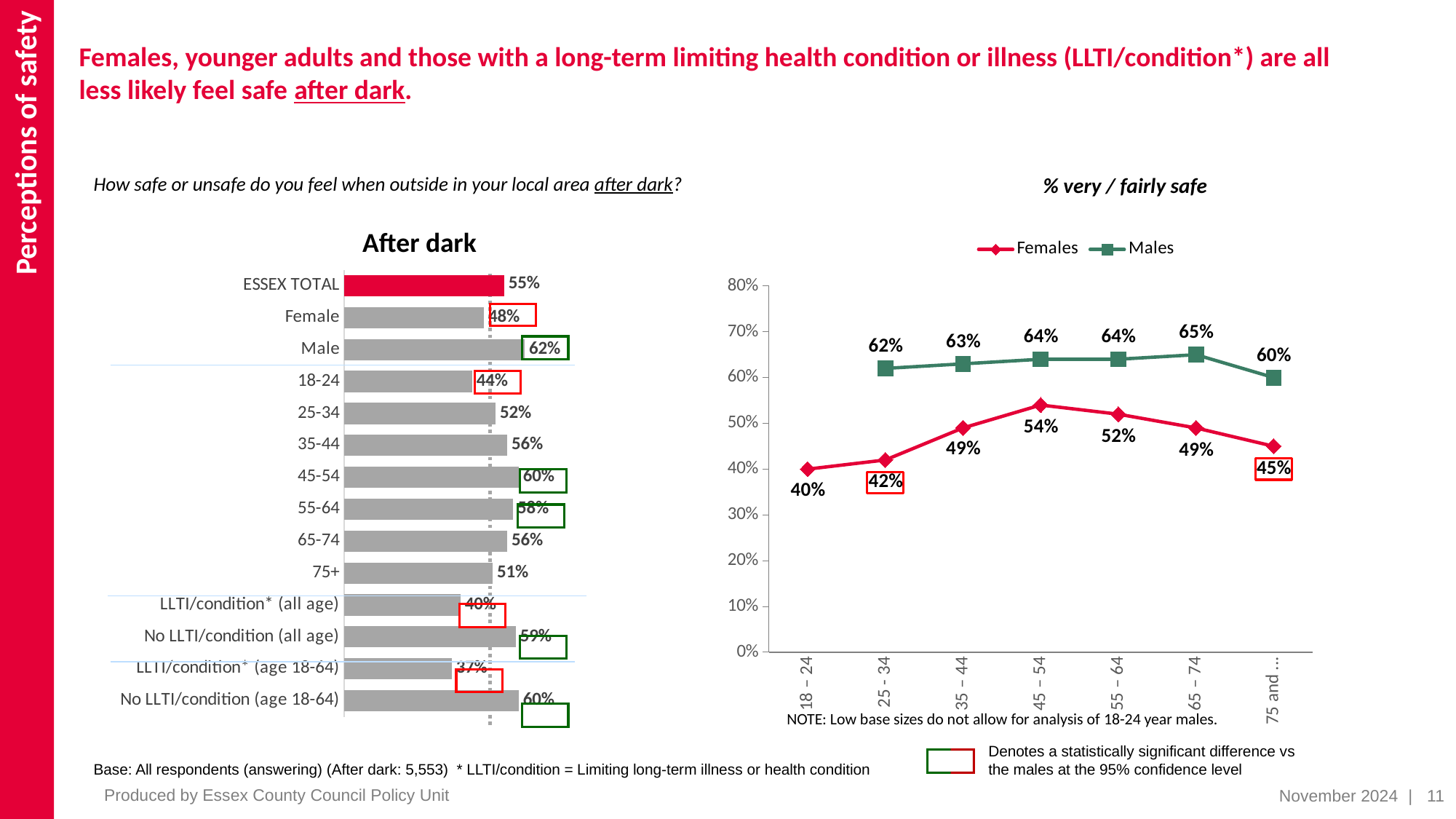
How many series does the legend of the '% very / fairly safe' chart list? 2 What type of chart is the '% very / fairly safe' chart on the right? Line chart In the '% very / fairly safe' chart, what is the difference between the Males and Females values for 25 – 34? 20 percentage points In the 'After dark' bar chart, what is the value for LLTI/condition* (age 18-64)? 37% In the 'After dark' bar chart, which category has the lowest value? LLTI/condition* (age 18-64) In the '% very / fairly safe' chart, what is the Females value for 45 – 54? 54% In the 'After dark' bar chart, which is larger: the value for 18-24 or the value for 75+? 75+ In the 'After dark' bar chart, what is the difference between the Male and Female values? 14 percentage points In the '% very / fairly safe' chart, which age group has the highest Males value? 65 – 74 In the 'After dark' bar chart, what is the value for Female? 48% In the 'After dark' bar chart, what is the value for ESSEX TOTAL? 55% How many categories are shown in the 'After dark' bar chart? 14